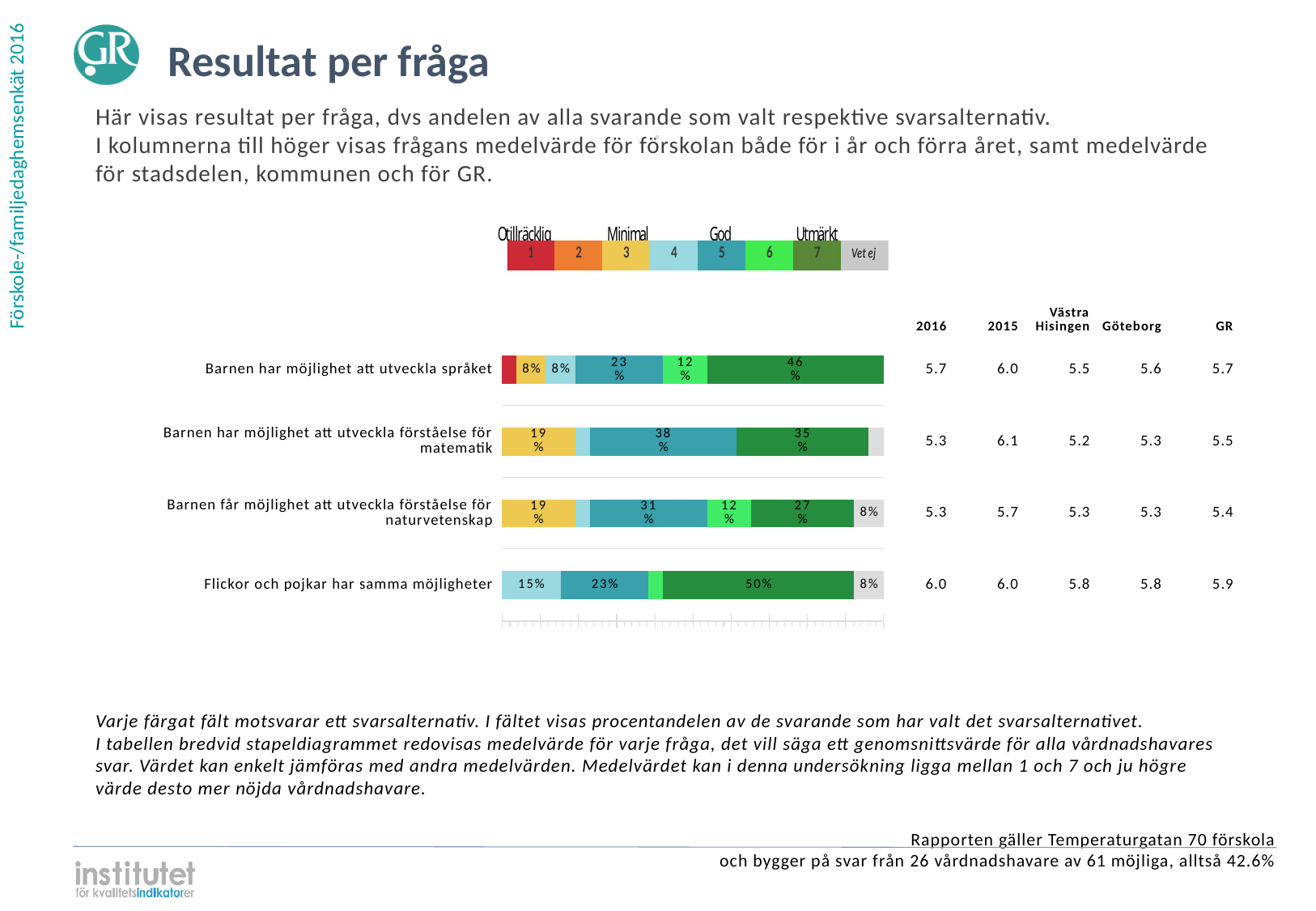
What percentage of respondents chose the dark green (7) alternative for 'Flickor och pojkar har samma möjligheter'? 50% How many questions (categories) are plotted in the bar chart? 4 What kind of chart is shown on the slide? Stacked bar chart How many answer alternatives does the legend above the chart list, including 'Vet ej'? 8 Which is larger: the teal (5) share for 'Barnen har möjlighet att utveckla förståelse för matematik' or for 'Barnen får möjlighet att utveckla förståelse för naturvetenskap'? Barnen har möjlighet att utveckla förståelse för matematik What percentage of respondents chose the teal (5) alternative for 'Barnen har möjlighet att utveckla förståelse för matematik'? 38% What percentage of respondents chose the dark green (7) alternative for 'Barnen har möjlighet att utveckla språket'? 46% In the table next to the chart, what is the 2016 mean value for 'Flickor och pojkar har samma möjligheter'? 6.0 What percentage of respondents answered 'Vet ej' (grey) for 'Barnen får möjlighet att utveckla förståelse för naturvetenskap'? 8% What is the title of the slide? Resultat per fråga Which question has the largest share for the dark green (7) alternative? Flickor och pojkar har samma möjligheter What is the difference between the dark green (7) share for 'Barnen har möjlighet att utveckla språket' and for 'Barnen får möjlighet att utveckla förståelse för naturvetenskap'? 19 percentage points